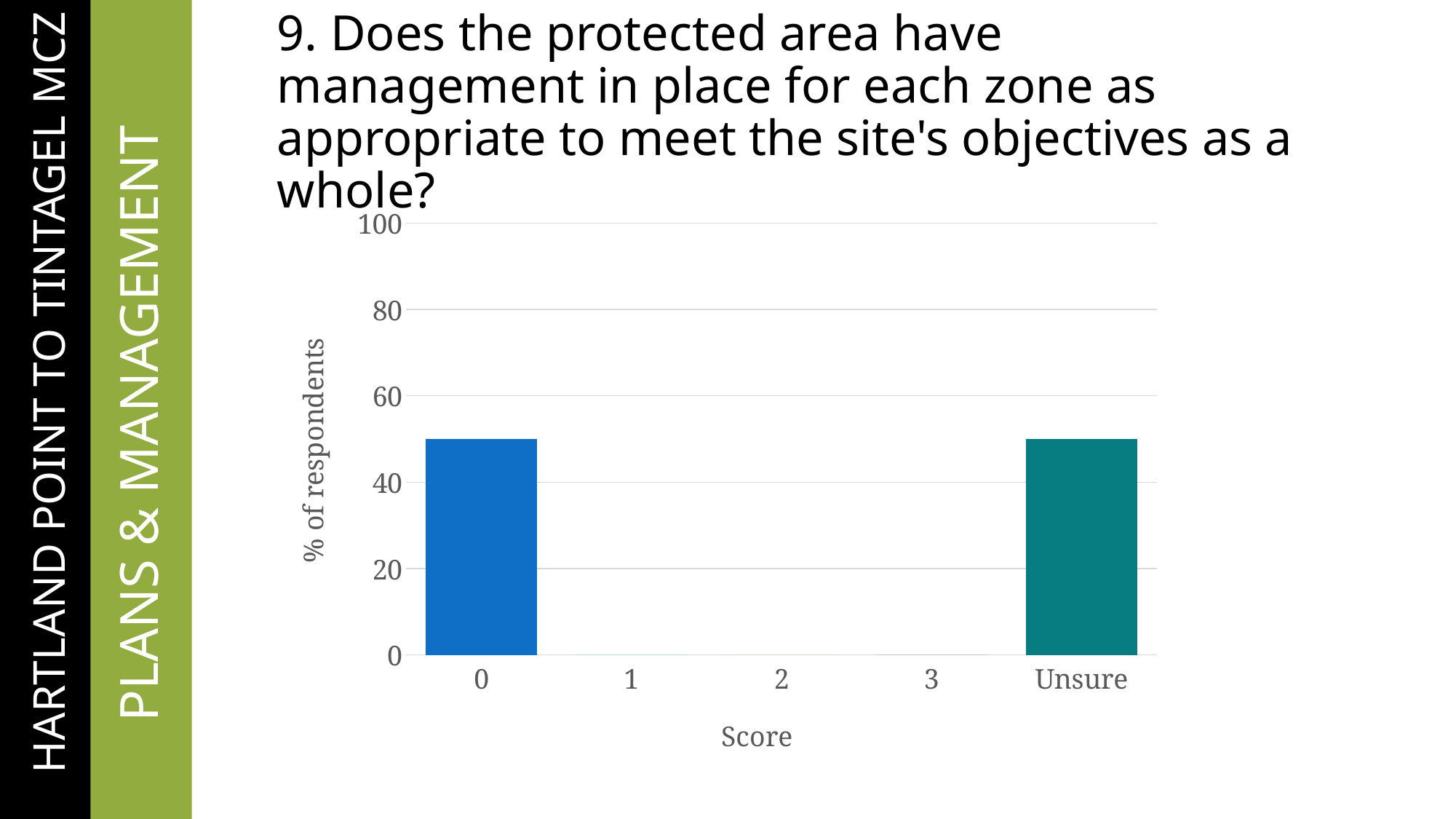
What kind of chart is shown on the slide? bar chart How many categories are shown on the x axis of the chart? 5 Which is larger, the value for Unsure or the value for score 3? Unsure What is the value for score 3? 0 What is the value for score 1? 0 Which is larger, the value for score 0 or the value for score 2? score 0 Is the value for score 0 greater or less than 60? less What is the title of the y axis of the chart? % of respondents What is the title of the x axis of the chart? Score Is the value for Unsure greater or less than 40? greater Is the value for Unsure greater or less than 60? less